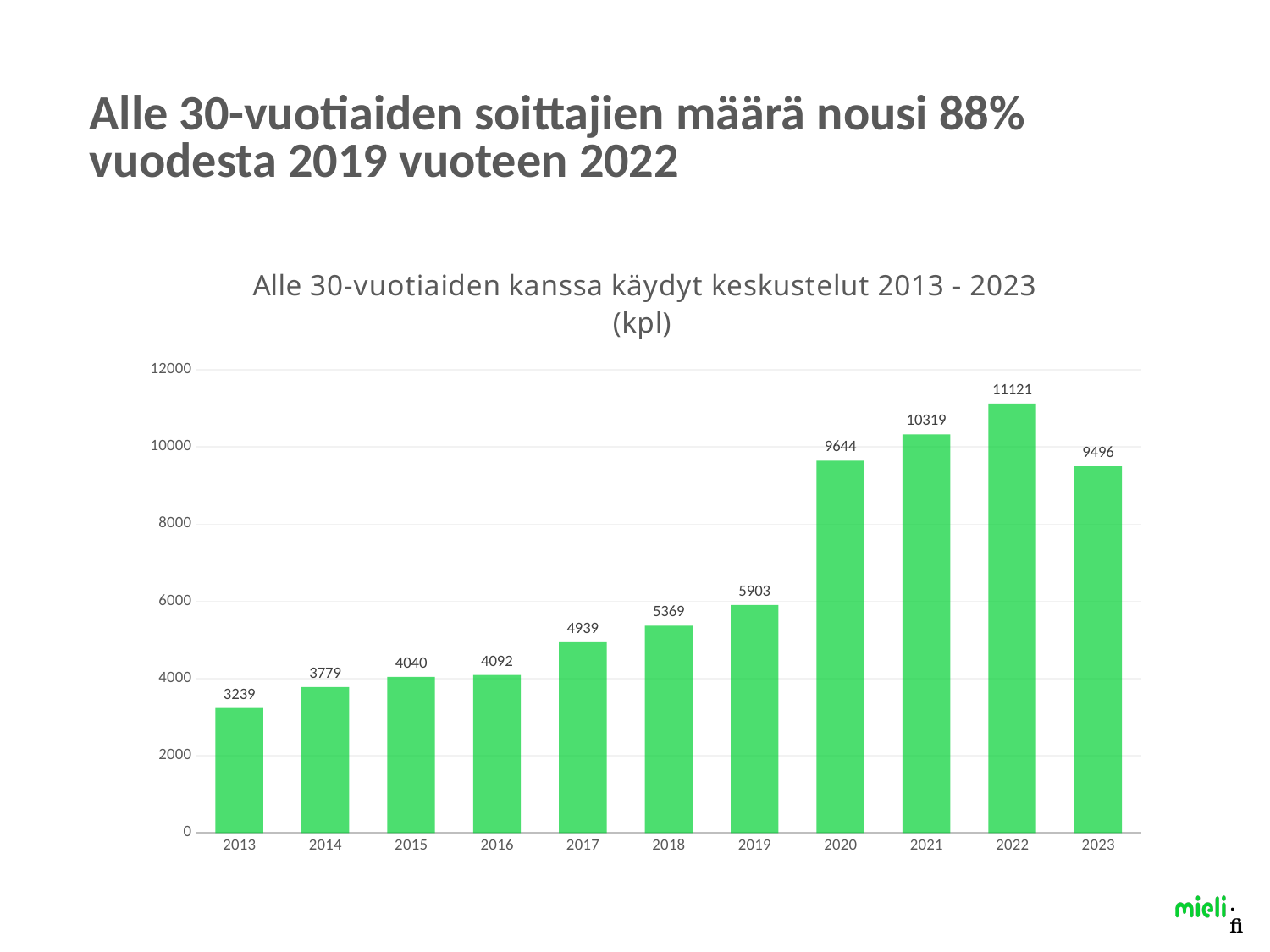
Which is larger, the value for 2021 or the value for 2023? 2021 What is the title of the chart? Alle 30-vuotiaiden kanssa käydyt keskustelut 2013 - 2023 (kpl) What is the difference between the values for 2022 and 2019? 5218 What kind of chart is this? bar chart Which year has the lowest value? 2013 How many years are shown on the x axis? 11 Is the value for 2020 greater or less than 8000? greater What is the value for 2022? 11121 Do the values rise or fall from 2013 to 2022? rise Which year has the highest value? 2022 What is the value for 2013? 3239 What is the value for 2019? 5903